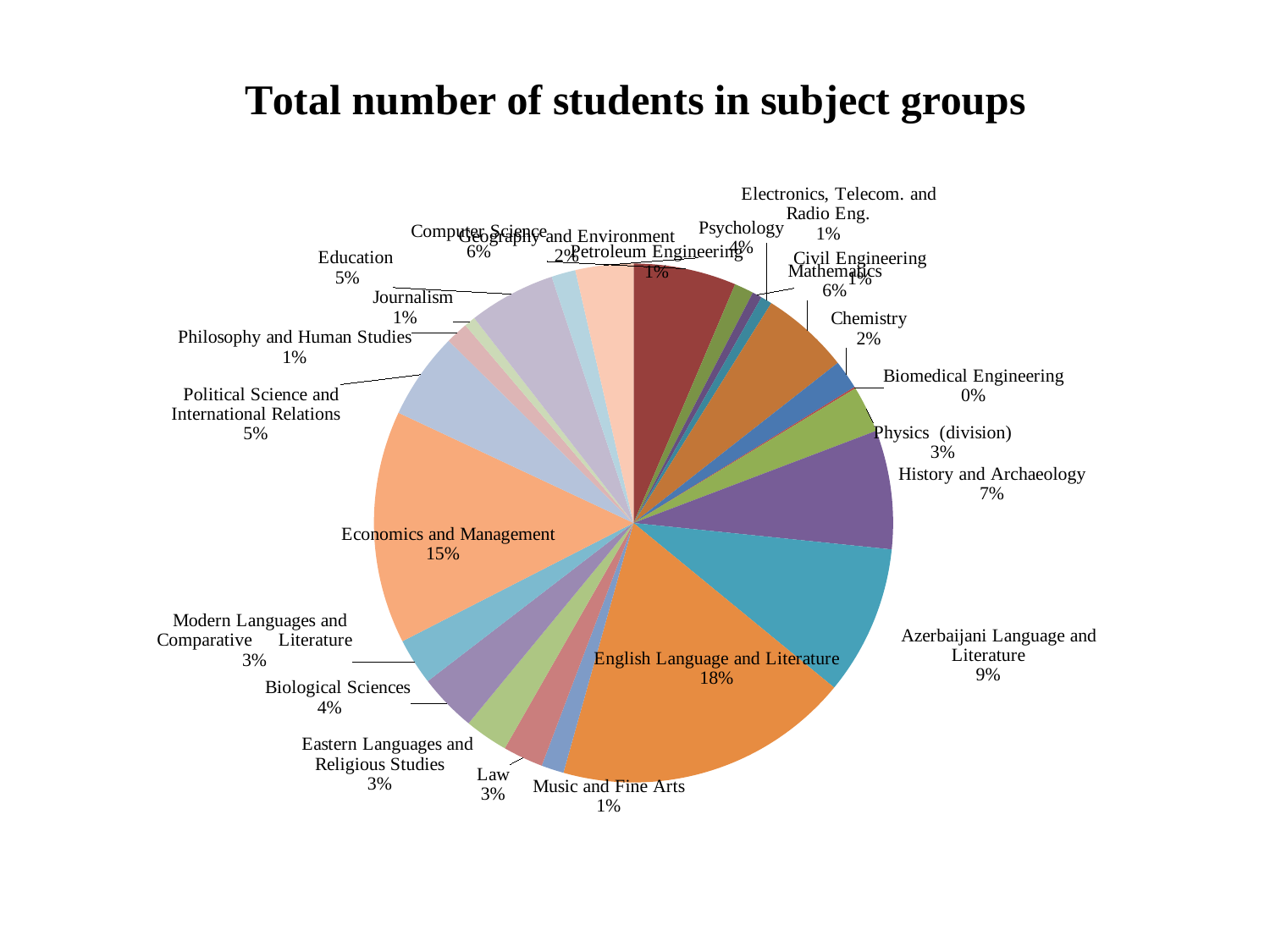
What is the title of the chart? Total number of students in subject groups What percentage is shown for Biomedical Engineering? 0% What percentage of students is in History and Archaeology? 7% What share of students is in English Language and Literature? 18% Which subject group has the largest share of students? English Language and Literature What percentage of students is in Azerbaijani Language and Literature? 9% What percentage of students is in Economics and Management? 15% Which has a larger share of students, Political Science and International Relations or Law? Political Science and International Relations What kind of chart is shown on the slide? pie chart By how many percentage points does English Language and Literature exceed Economics and Management? 3 Which has a larger share of students, Azerbaijani Language and Literature or History and Archaeology? Azerbaijani Language and Literature What percentage of students is in Psychology? 4%